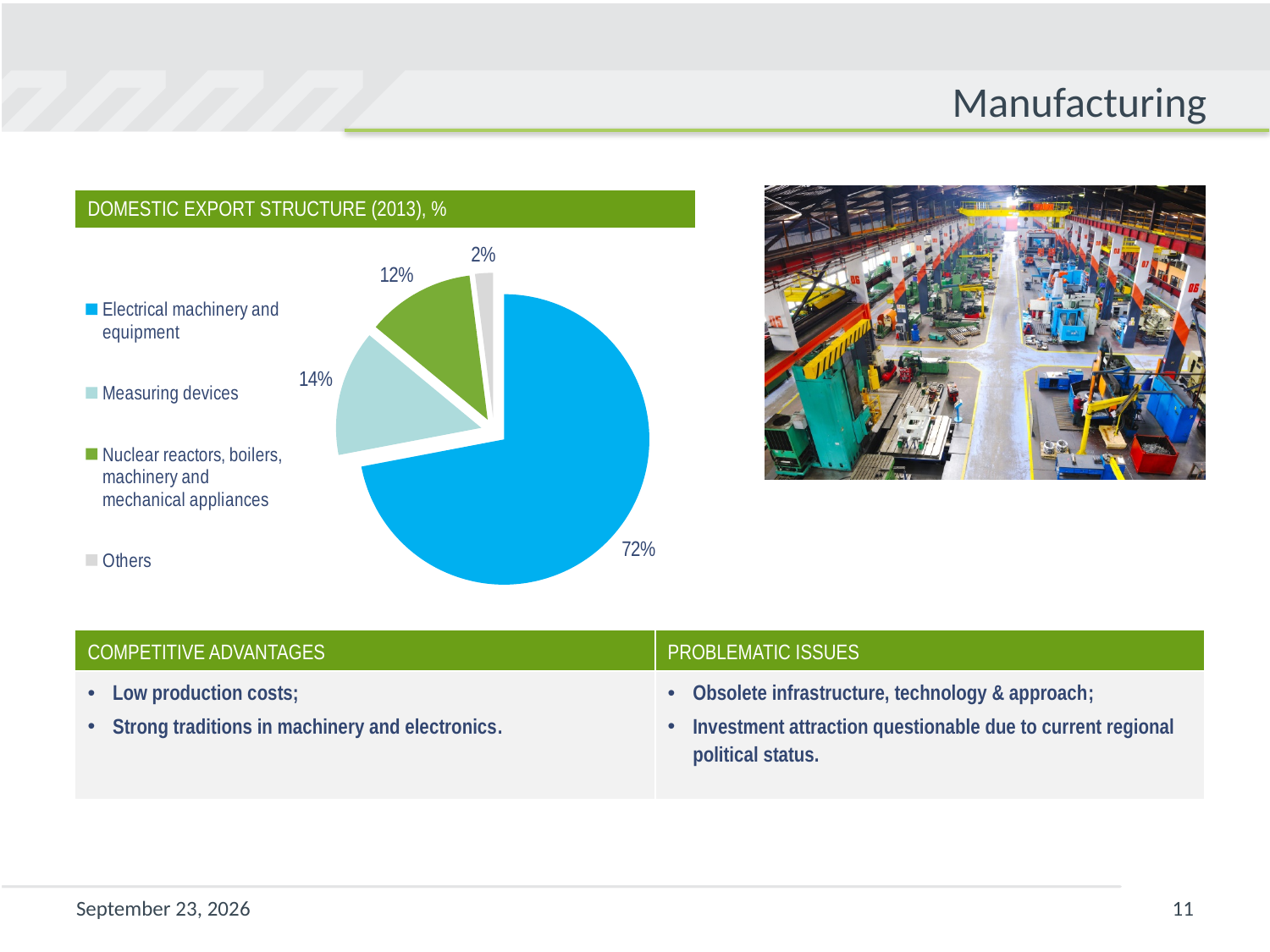
Which has a larger share: Measuring devices or Nuclear reactors, boilers, machinery and mechanical appliances? Measuring devices Which category has the smallest share of domestic exports? Others What share of domestic exports does Nuclear reactors, boilers, machinery and mechanical appliances account for? 12% What colour is the slice for Electrical machinery and equipment? Blue What share of domestic exports does Others account for? 2% What share of domestic exports does Measuring devices account for? 14% What is the difference in percentage points between Electrical machinery and equipment and Measuring devices? 58 Which category has the largest share of domestic exports? Electrical machinery and equipment What is the title of the chart? DOMESTIC EXPORT STRUCTURE (2013), % How many categories are shown in the pie chart? 4 What kind of chart is used to show the domestic export structure? Pie chart What share of domestic exports does Electrical machinery and equipment account for? 72%